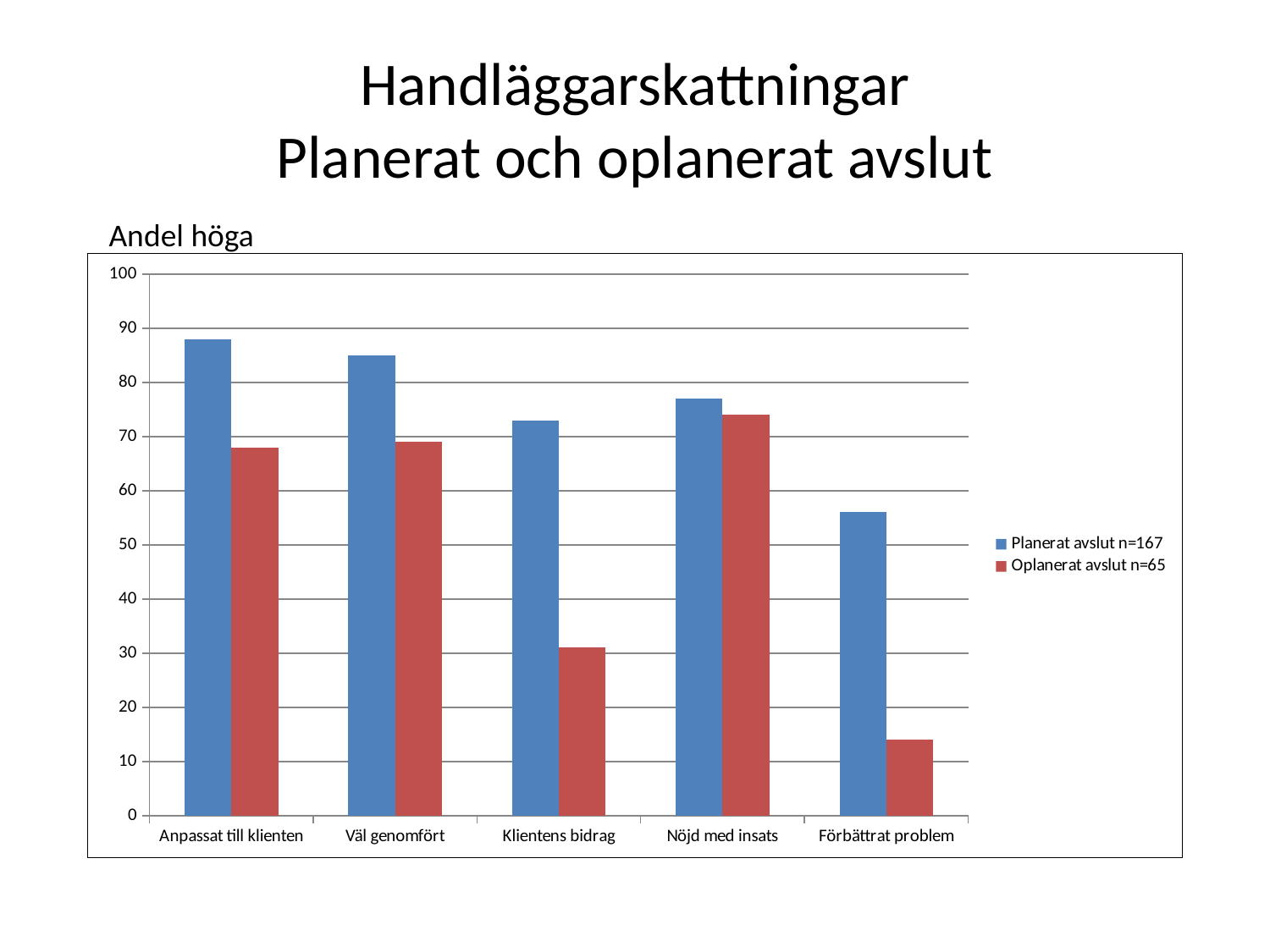
How many series does the chart's legend list? 2 Which category has the lowest value for Planerat avslut n=167? Förbättrat problem Which category has the highest value for Oplanerat avslut n=65? Nöjd med insats Is the value for Planerat avslut n=167 in the category Förbättrat problem greater or less than 50? greater What label is written above the chart, describing what the values represent? Andel höga Is the value for Planerat avslut n=167 in the category Anpassat till klienten greater or less than 80? greater Which is larger: the Planerat avslut n=167 value for Förbättrat problem or the Oplanerat avslut n=65 value for Nöjd med insats? Oplanerat avslut n=65 value for Nöjd med insats In the category Klientens bidrag, which series has the larger value, Planerat avslut n=167 or Oplanerat avslut n=65? Planerat avslut n=167 Is the value for Oplanerat avslut n=65 in the category Klientens bidrag greater or less than 40? less How many categories are shown on the x axis of the chart? 5 What kind of chart is shown on the slide? bar chart